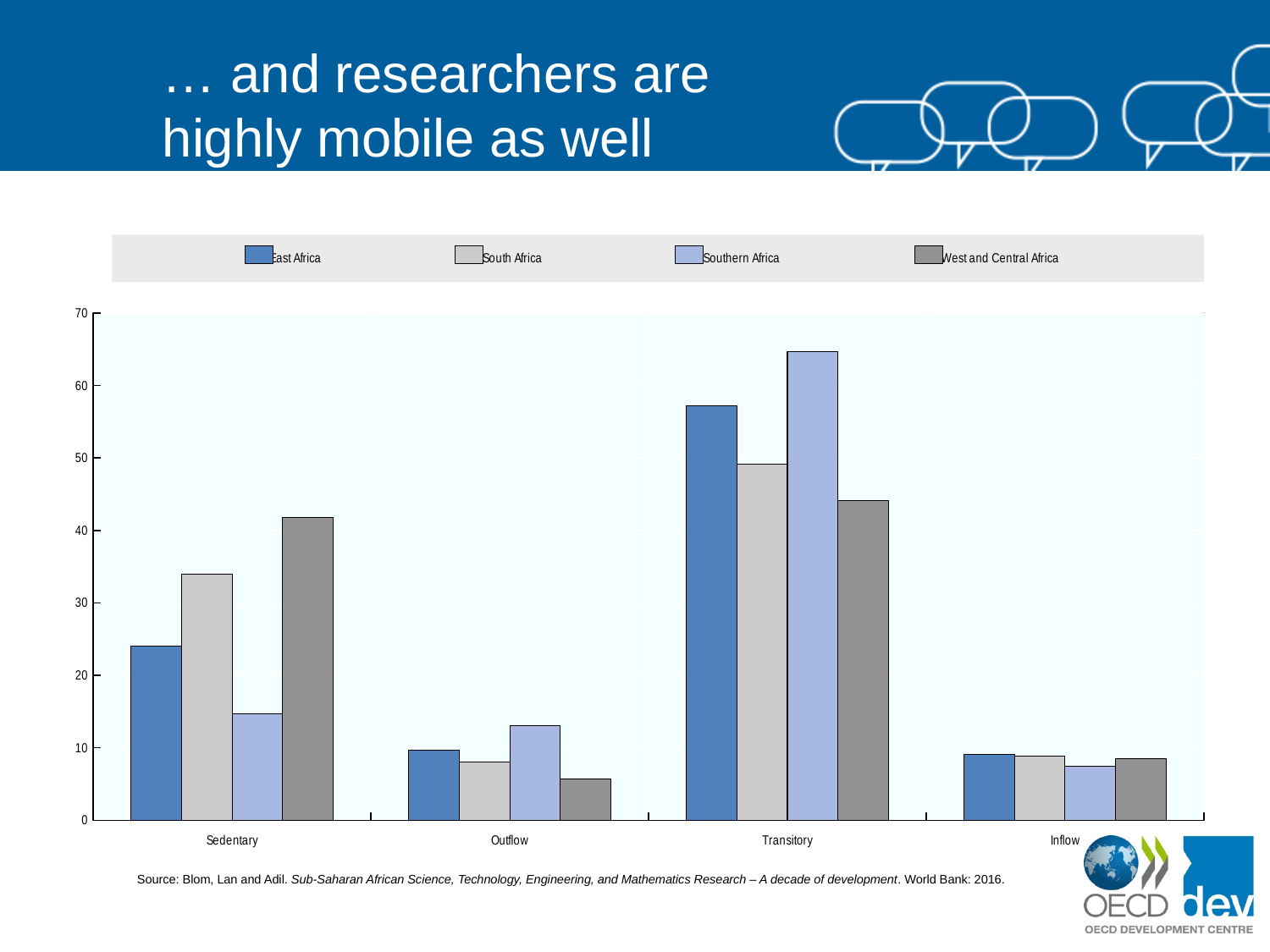
Which legend entry is shown with the darkest grey colour? West and Central Africa Is the value for Southern Africa in the Transitory category greater or less than 60? greater What kind of chart is shown on the slide? bar chart How many categories are shown on the x axis? 4 Which series has the highest value in the Sedentary category? West and Central Africa In which category does East Africa have its highest value? Transitory Which series has the highest value in the Transitory category? Southern Africa How many series does the legend list? 4 Is the value for West and Central Africa in the Sedentary category greater or less than 40? greater In the Outflow category, which is larger: the value for Southern Africa or the value for West and Central Africa? Southern Africa Which series has the lowest value in the Sedentary category? Southern Africa Which series has the lowest value in the Transitory category? West and Central Africa